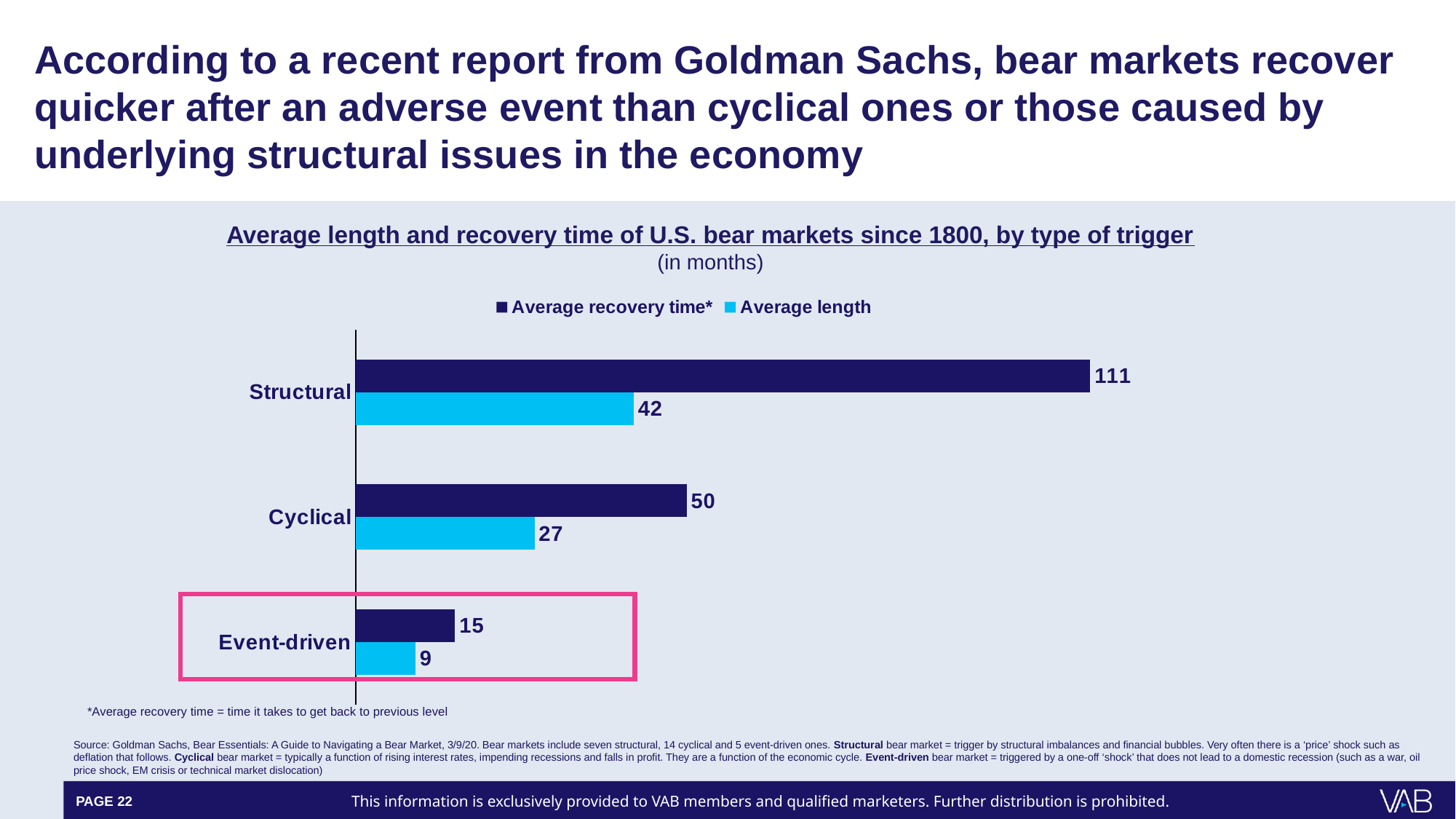
How much longer is the average recovery time for Cyclical bear markets than for Event-driven ones? 35 What is the average recovery time for Structural bear markets? 111 What is the average length of Event-driven bear markets? 9 What is the difference between the average recovery time and the average length for Structural bear markets? 69 How many types of trigger are shown on the chart? 3 What is the average length of Cyclical bear markets? 27 Which type of trigger has the lowest average length? Event-driven In what unit are the values on the chart expressed? Months Which is larger: the average length of Structural bear markets or the average recovery time of Cyclical bear markets? Average recovery time of Cyclical bear markets What kind of chart is shown on the slide? Bar chart How many series does the legend list? 2 Which type of trigger has the highest average recovery time? Structural